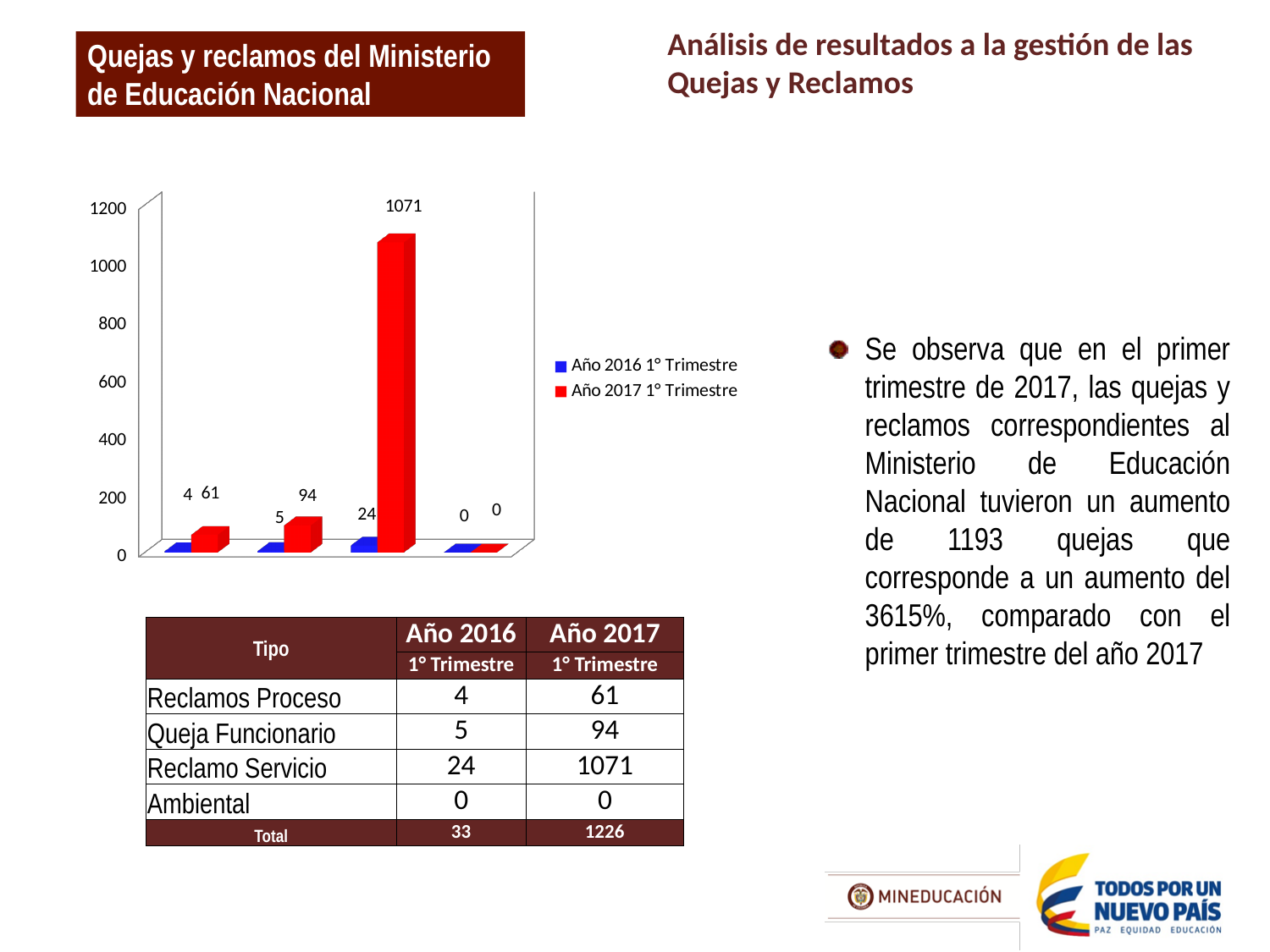
Which series does the blue bar represent in the chart? Año 2016 1° Trimestre Which is larger for Queja Funcionario: the Año 2016 1° Trimestre value or the Año 2017 1° Trimestre value? Año 2017 1° Trimestre What kind of chart is shown on the slide? bar chart What is the value for Reclamo Servicio in the Año 2017 1° Trimestre series? 1071 Is the Año 2017 1° Trimestre value for Reclamo Servicio greater or less than 1000? greater What is the value for Queja Funcionario in the Año 2017 1° Trimestre series? 94 What is the difference between the Año 2017 and Año 2016 values for Reclamo Servicio? 1047 What is the highest data label shown in the chart? 1071 How many series does the chart legend list? 2 How many categories are plotted in the chart? 4 What is the value for Reclamos Proceso in the Año 2016 1° Trimestre series? 4 Which series does the red bar represent in the chart? Año 2017 1° Trimestre